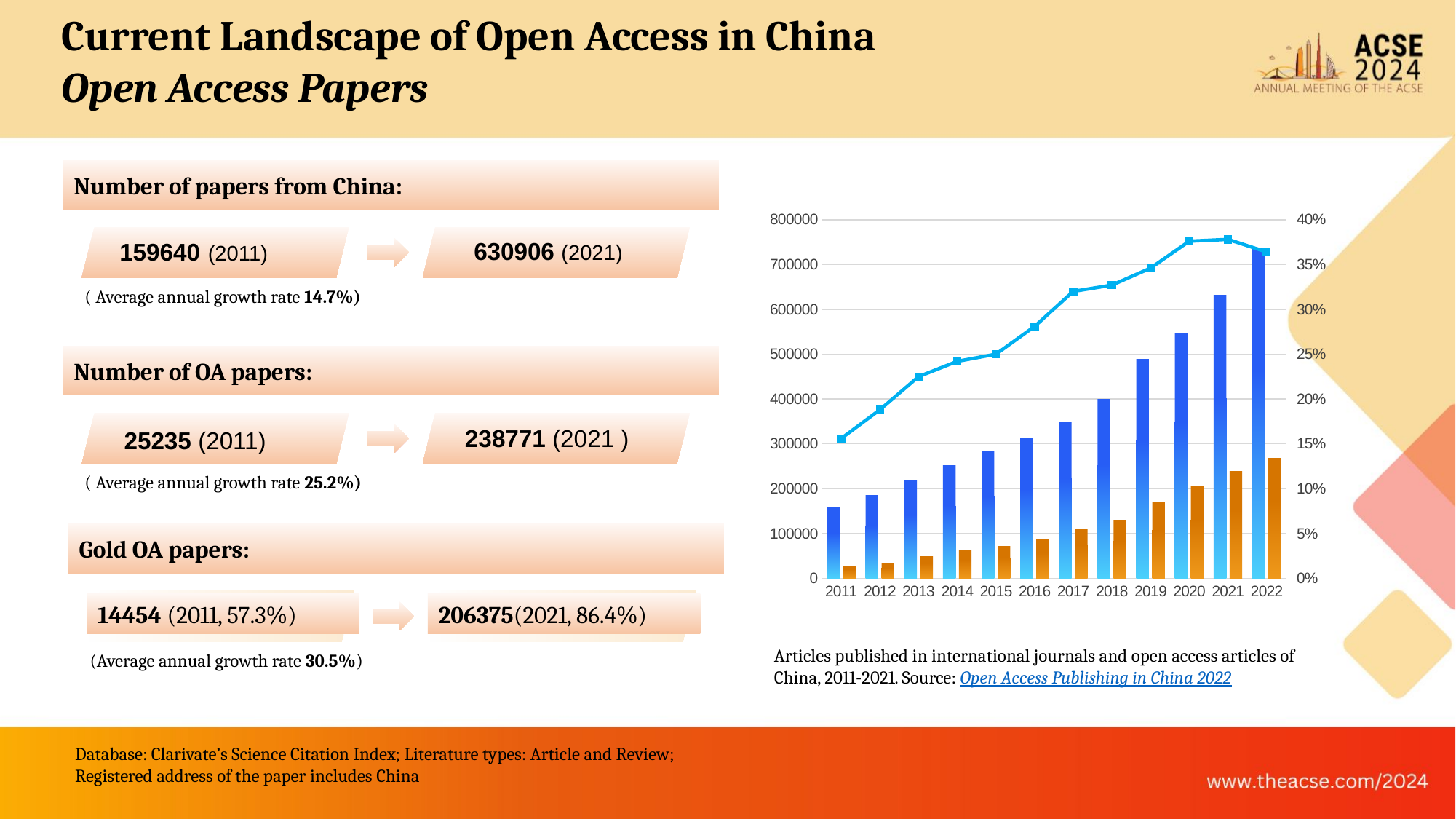
Is the orange bar for 2016 greater or less than 100000? less Is the line value for 2011 greater or less than 20%? less Which year has the larger blue bar, 2020 or 2021? 2021 What kind of chart is shown on the right of the slide? bar chart with a line Do the blue bars rise or fall from 2011 to 2022? rise Which year has the tallest blue bar in the chart? 2022 Is the blue bar for 2021 greater or less than 600000? greater What is the highest tick shown on the right-hand percentage axis of the chart? 40% How many years are shown on the x axis of the chart? 12 Which year has the shortest blue bar in the chart? 2011